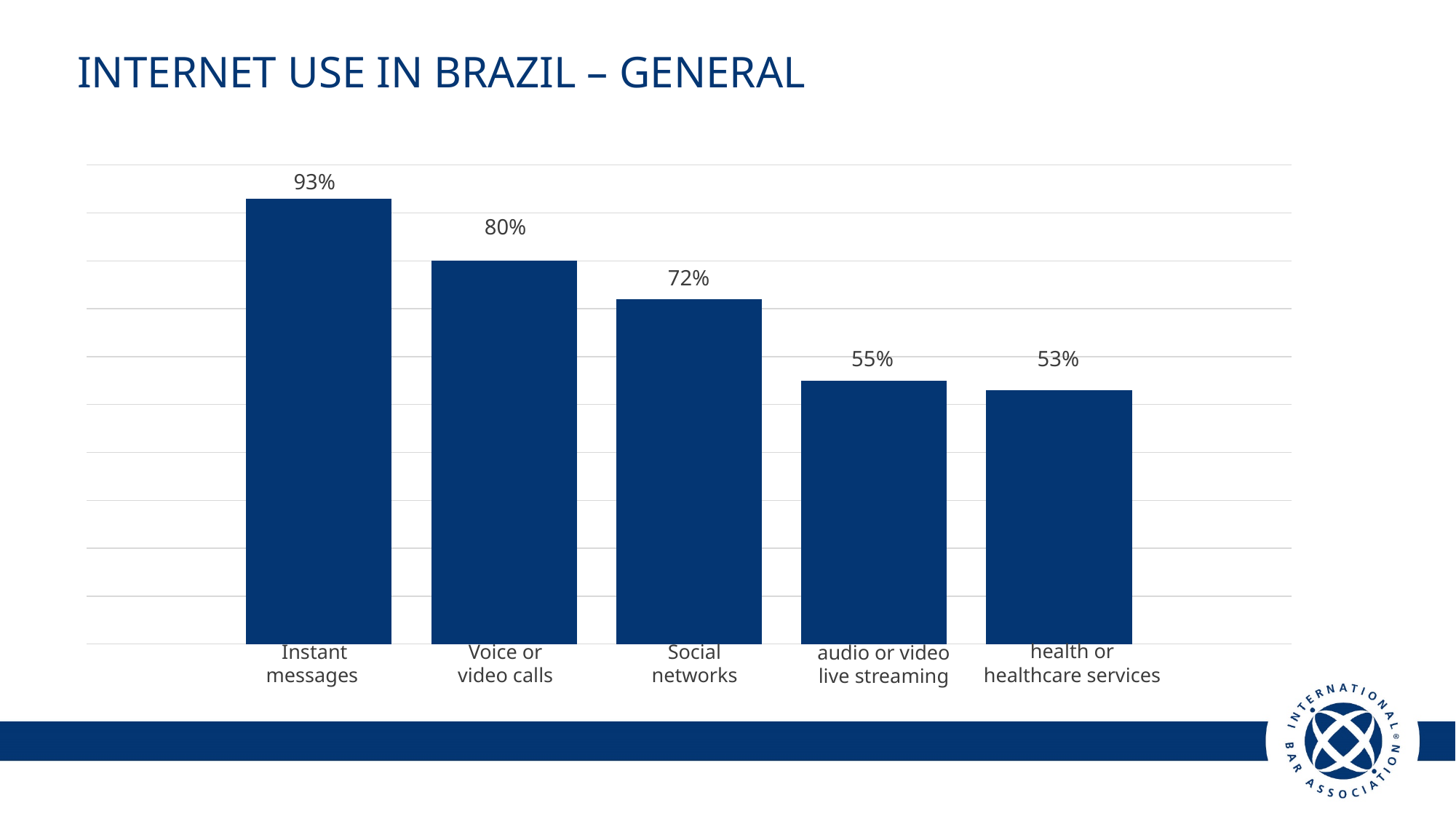
What is the value for Voice or video calls? 80% Which category has the lowest value? health or healthcare services What is the value for audio or video live streaming? 55% Do the values rise or fall from left to right across the categories? Fall What is the value for Instant messages? 93% How many categories are shown in the chart? 5 What is the difference between the values for Instant messages and Social networks? 21% Which category has the highest value? Instant messages What kind of chart is shown on the slide? Bar chart Which is larger, the value for Voice or video calls or the value for Social networks? Voice or video calls What is the value for Social networks? 72% What is the value for health or healthcare services? 53%